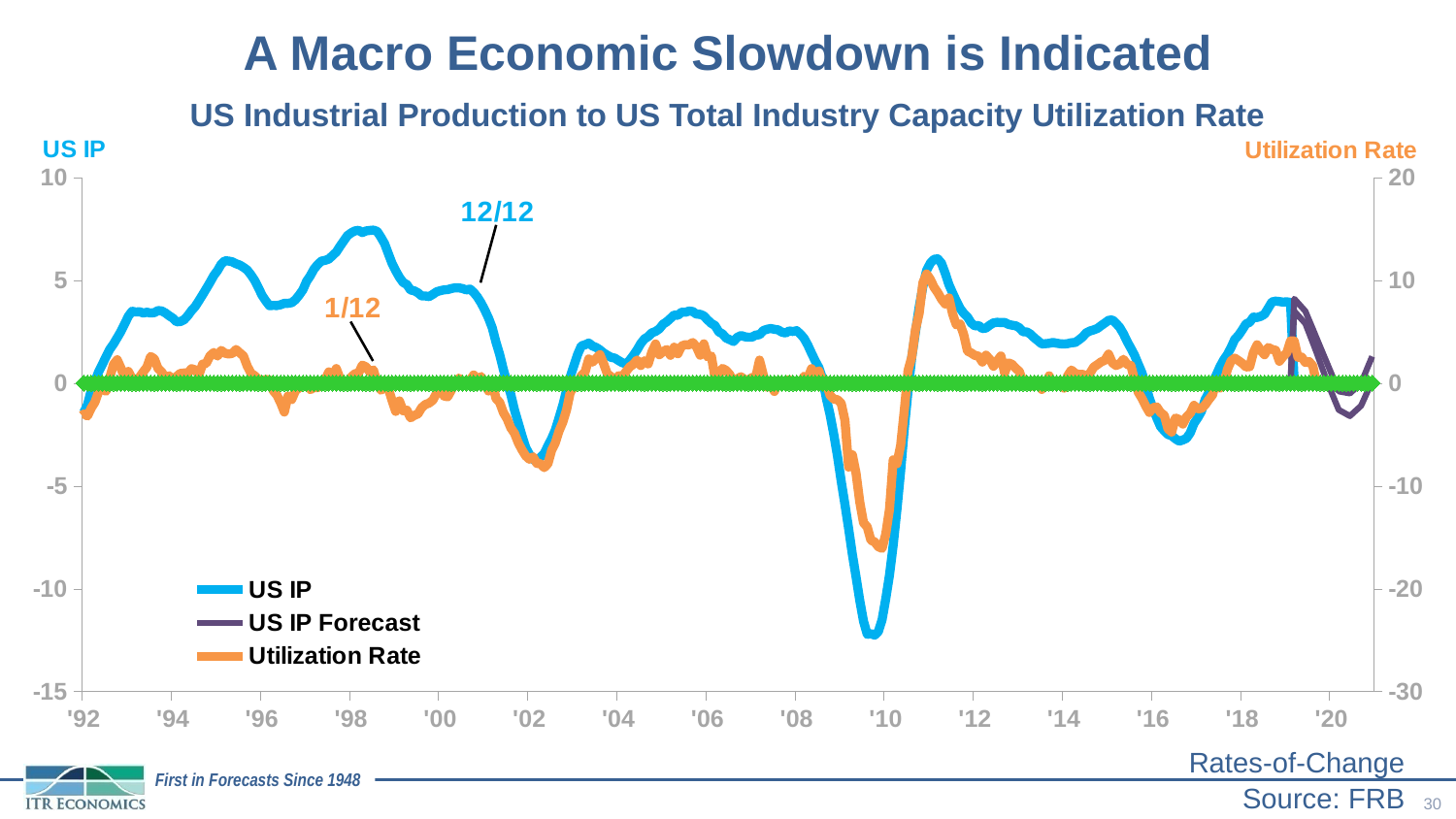
How many year labels are shown on the x axis? 15 Is the peak of the Utilization Rate line near '11 greater or less than 5 on the right axis? greater Between '16 and '18, does the US IP line rise or fall? rise What label is shown above the left vertical axis and what label is shown above the right vertical axis? US IP (left), Utilization Rate (right) What are the three series named in the legend? US IP, US IP Forecast, Utilization Rate Is the lowest value of the US IP line, near '10, greater or less than -10 on the left axis? less Is the peak of the US IP line near '98 greater or less than 5 on the left axis? greater Is the US IP value higher at '98 or at '04? '98 How many series does the legend list? 3 What kind of chart is shown on the slide? line chart Near which x-axis year label does the US IP line reach its lowest point? '10